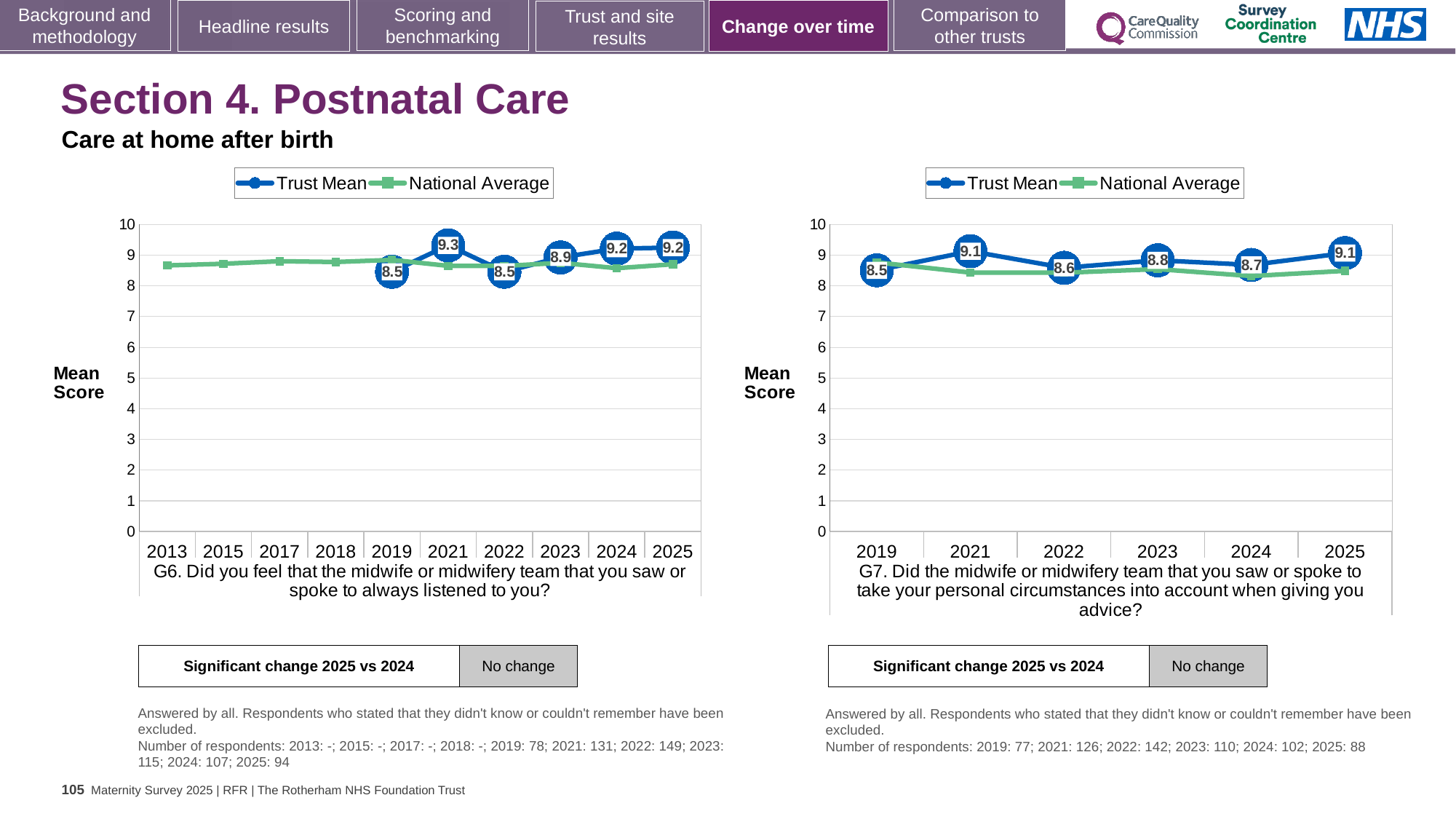
In the left chart (G6), what is the difference between the Trust Mean in 2021 and in 2022? 0.8 How many years are shown on the x axis of the right chart (G7)? 6 In the left chart (G6), what is the Trust Mean for 2021? 9.3 In the right chart (G7), what is the Trust Mean for 2024? 8.7 How many series does the legend of the left chart (G6) list? 2 What type of chart is the left chart (G6)? Line chart In the right chart (G7), what is the difference between the Trust Mean in 2025 and in 2019? 0.6 In the left chart (G6), is the National Average for 2013 greater or less than 8? greater In the left chart (G6), which year has the highest Trust Mean? 2021 What does the 'Significant change 2025 vs 2024' box below the right chart (G7) say? No change In the right chart (G7), which year has the lowest Trust Mean? 2019 In the right chart (G7), is the Trust Mean higher in 2021 or in 2022? 2021